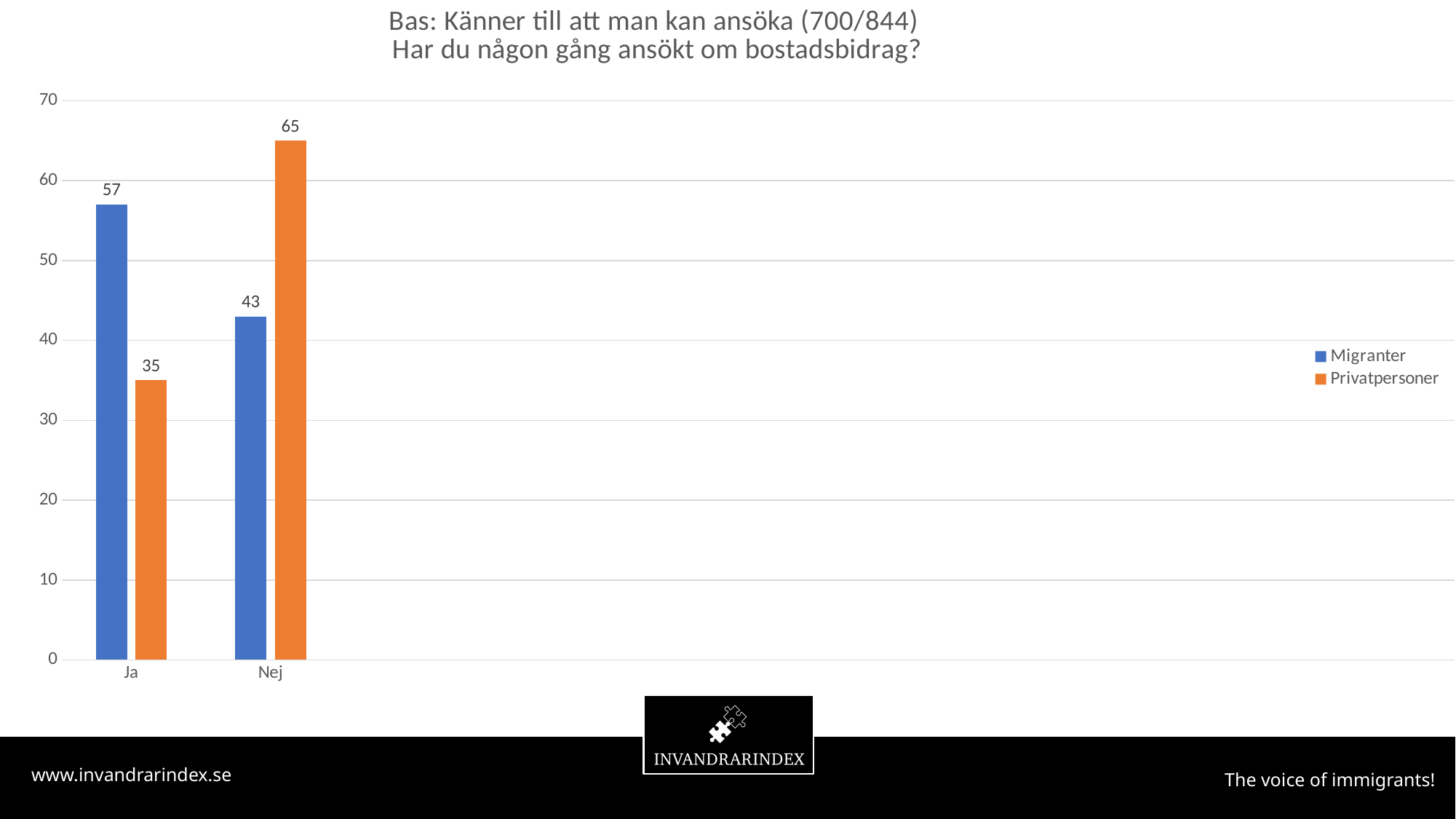
Which category has the lowest value for Migranter? Nej Which category has the highest value for Privatpersoner? Nej What is the value for Migranter in the Nej category? 43 How many series does the legend list? 2 What is the value for Privatpersoner in the Ja category? 35 Which series has the larger value in the Nej category, Migranter or Privatpersoner? Privatpersoner What is the difference between Migranter and Privatpersoner in the Ja category? 22 What is the value for Privatpersoner in the Nej category? 65 What kind of chart is shown on the slide? bar chart How many categories are shown on the x axis? 2 What is the value for Migranter in the Ja category? 57 Is the value for Migranter in the Ja category greater or less than 50? greater